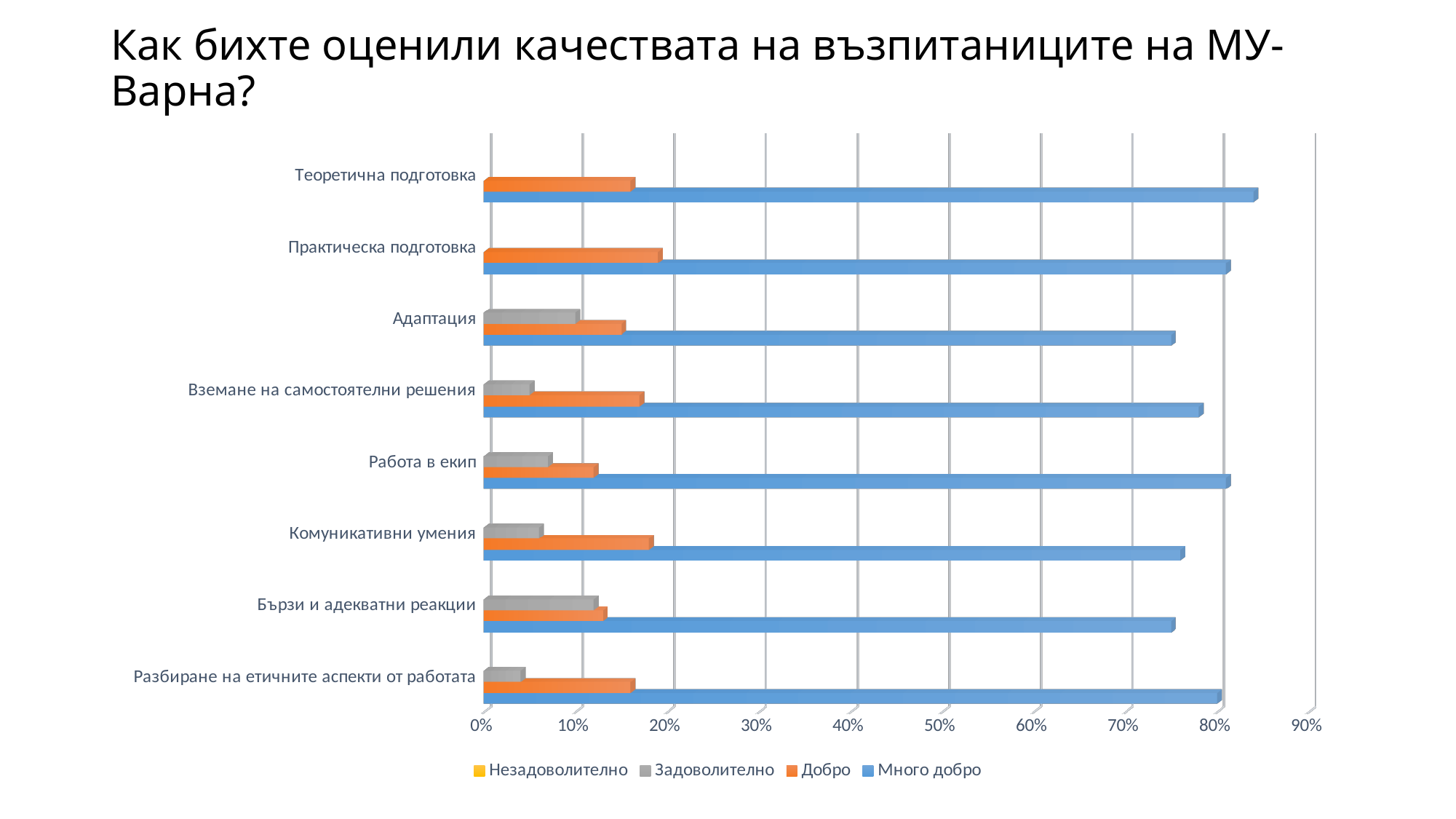
Which is larger: the "Много добро" value for "Теоретична подготовка" or for "Адаптация"? Теоретична подготовка Is the "Много добро" value for "Теоретична подготовка" greater or less than 80%? greater Is the "Задоволително" value for "Бързи и адекватни реакции" greater or less than 10%? greater Which is larger: the "Добро" value for "Практическа подготовка" or for "Работа в екип"? Практическа подготовка Is the "Задоволително" value for "Разбиране на етичните аспекти от работата" greater or less than 10%? less Which category has the highest value for the "Много добро" series? Теоретична подготовка What colour represents the "Много добро" series in the chart? Blue How many categories (qualities) are listed on the vertical axis of the chart? 8 How many series does the chart legend list? 4 What kind of chart is shown on the slide? Bar chart